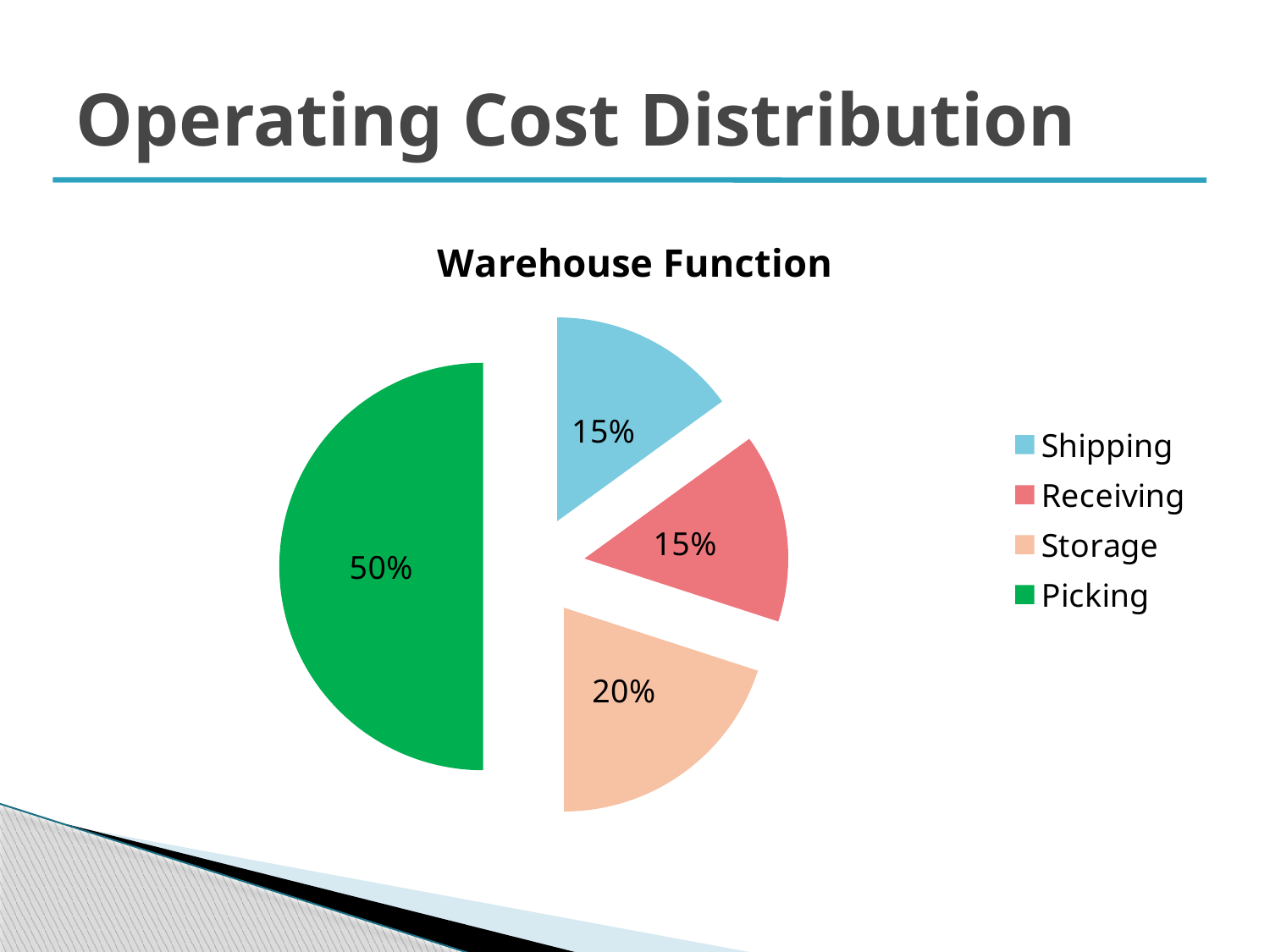
How many entries does the legend list? 4 What is the chart's title? Warehouse Function What colour is the Picking slice? green Which warehouse function has the largest share of operating cost? Picking What is the value shown for Receiving? 15% What is the difference between the Picking share and the Storage share? 30% What is the value shown for Storage? 20% Which is larger, the share for Storage or the share for Shipping? Storage What type of chart is shown on the slide? pie chart What share of the pie does Picking account for? 50% What is the value shown for Shipping? 15% How many slices does the pie chart have? 4